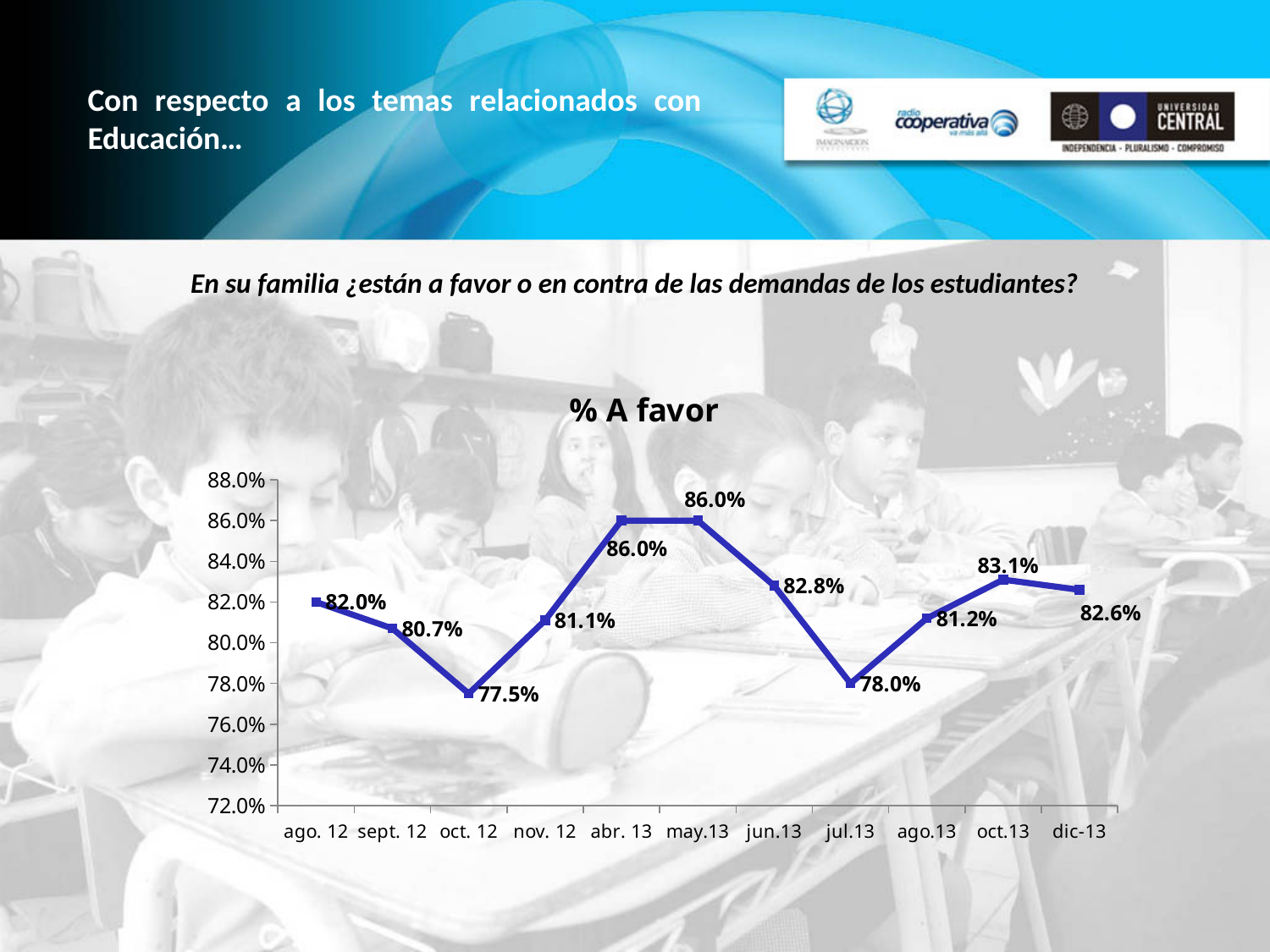
What is the value for dic-13? 82.6% Which period has the lowest value? oct. 12 What is the value for jun.13? 82.8% What is the value for oct. 12? 77.5% What is the difference between the values for may.13 and jul.13? 8.0% Do the values rise or fall from jul.13 to oct.13? rise What is the highest value shown on the chart? 86.0% How many data points are plotted on the chart? 11 What type of chart is shown on the slide? line chart What is the title of the chart? % A favor Which is larger, the value for oct.13 or the value for ago.13? oct.13 What is the value for ago. 12? 82.0%